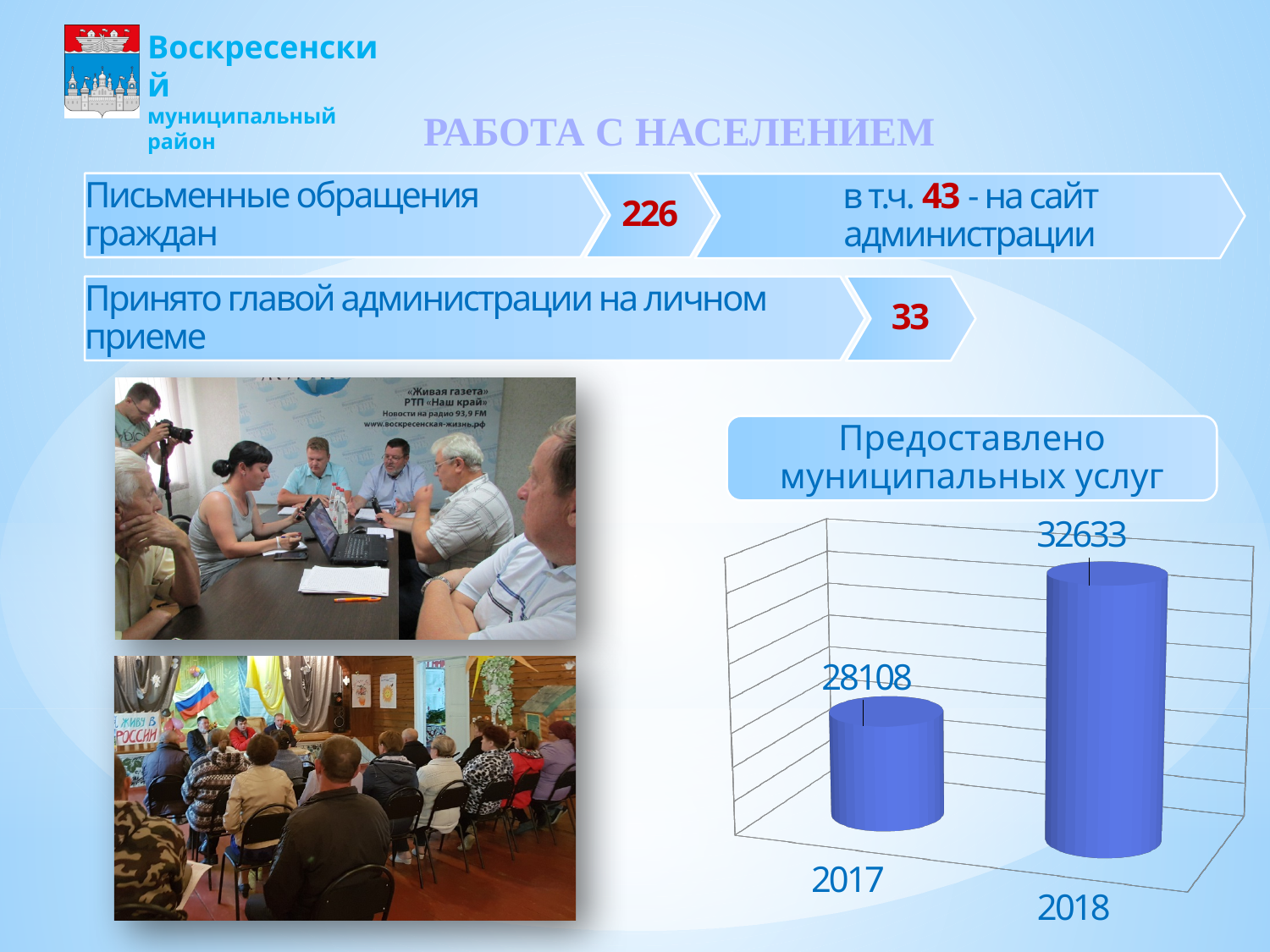
What value does the chart show for 2017? 28108 How many years (categories) are shown in the chart? 2 What value does the chart show for 2018? 32633 Do the values rise or fall from 2017 to 2018? rise By how much does the 2018 value exceed the 2017 value? 4525 Which year has the higher value in the chart? 2018 What kind of chart is shown on the slide? bar chart Which year has the lower value in the chart? 2017 What is the title of the chart? Предоставлено муниципальных услуг What colour are the bars in the chart? blue Is the value for 2018 larger or smaller than the value for 2017? larger